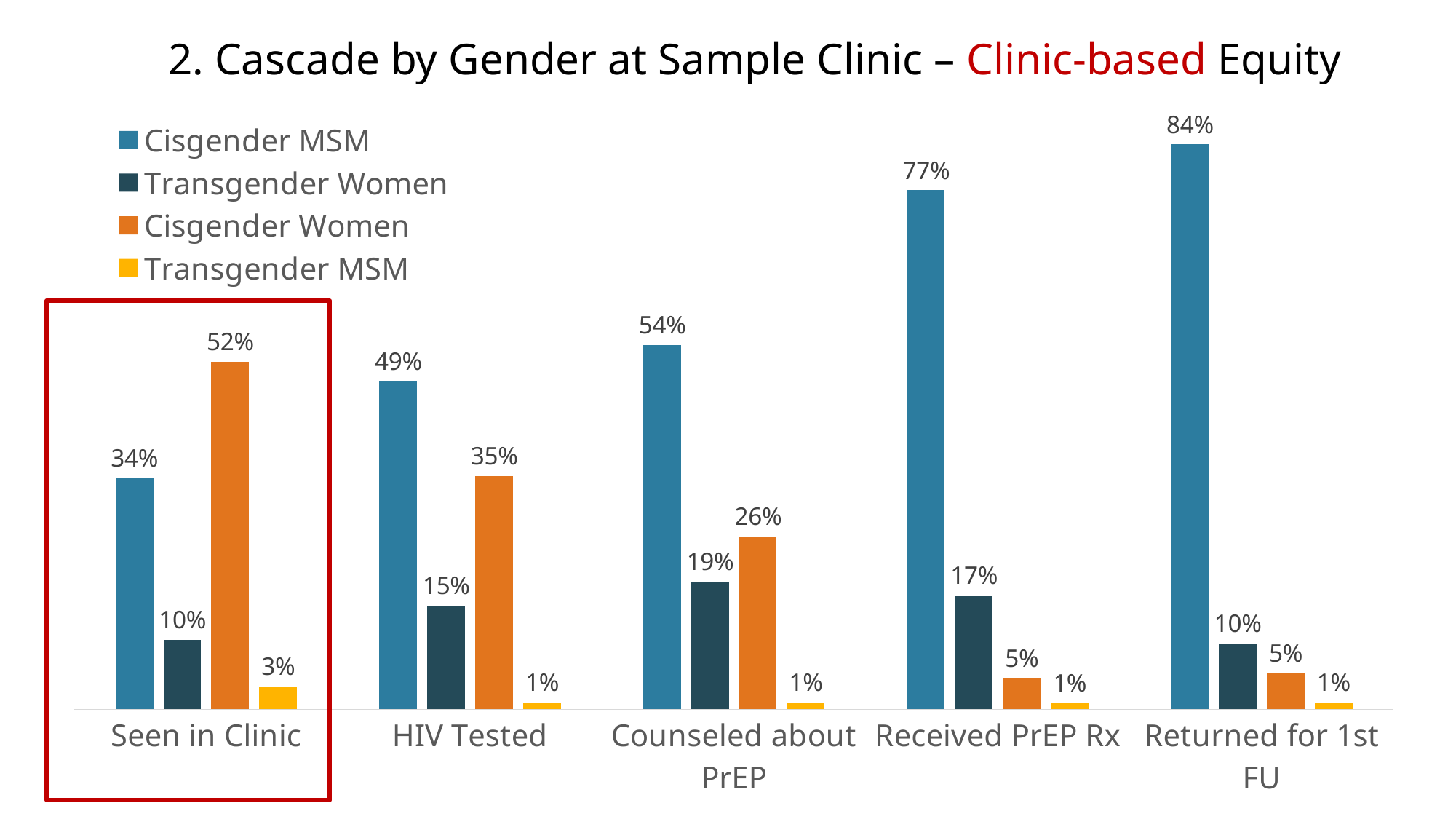
How many categories are shown on the x axis? 5 What kind of chart is shown on the slide? Bar chart What is the difference between the Cisgender MSM and Cisgender Women values in the HIV Tested category? 14% What is the value for Transgender Women in the Counseled about PrEP category? 19% Which series has the lowest value in the Received PrEP Rx category? Transgender MSM Which series has the highest value in the Seen in Clinic category? Cisgender Women What is the value for Cisgender Women in the Seen in Clinic category? 52% Which is larger: Cisgender MSM in Seen in Clinic or Cisgender Women in Seen in Clinic? Cisgender Women in Seen in Clinic Do the Cisgender Women values rise or fall from Seen in Clinic to Returned for 1st FU? Fall How many series does the legend list? 4 What is the value for Transgender MSM in the Seen in Clinic category? 3% What is the value for Cisgender MSM in the Returned for 1st FU category? 84%